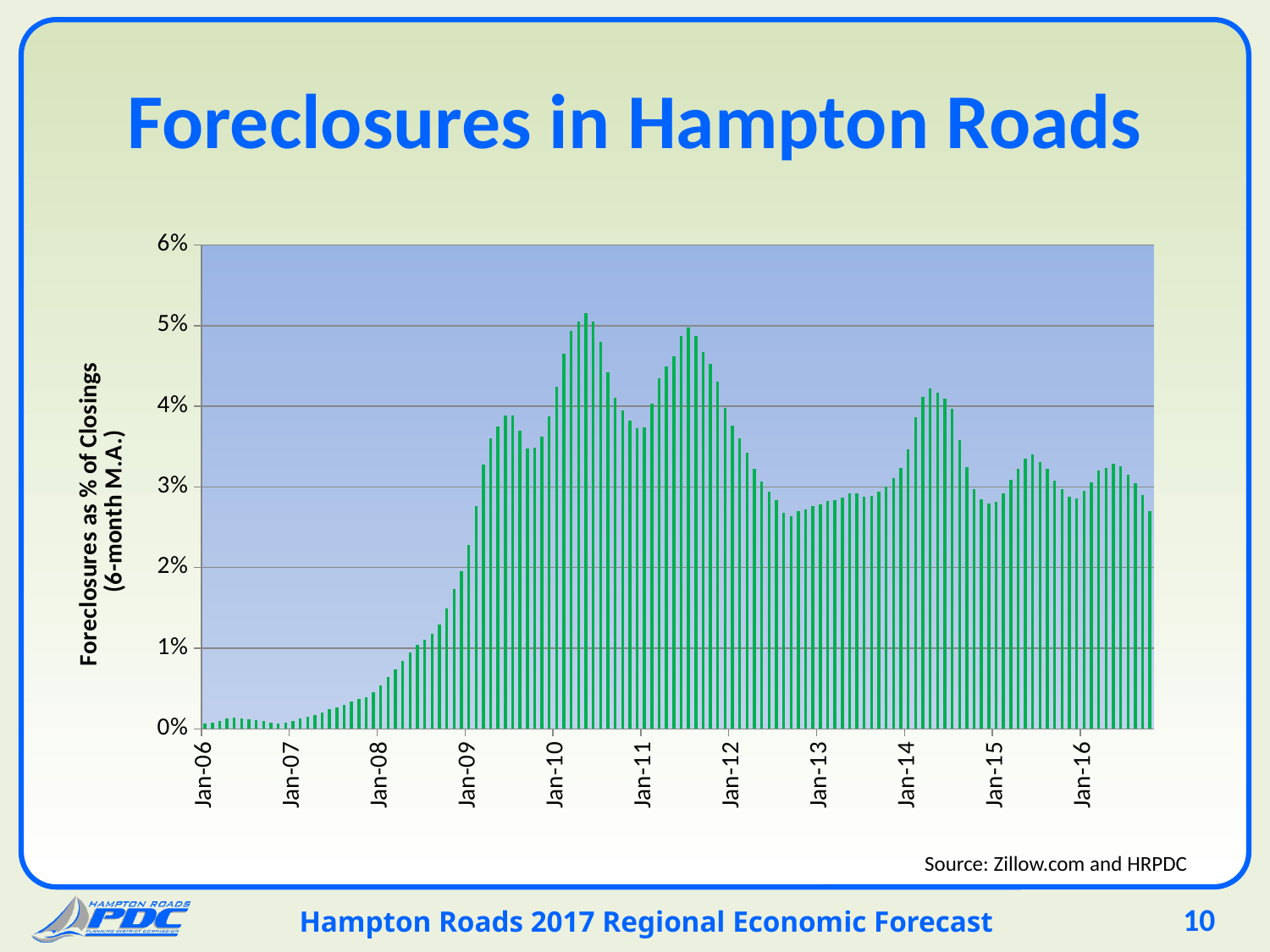
Is the value for Jan-06 greater or less than 1%? less Is the value for Jan-13 greater or less than 3%? less What kind of chart is shown on the slide? bar chart Which is larger, the value for Jan-10 or the value for Jan-13? Jan-10 Is the value for Jan-14 greater or less than 3%? greater What is the label on the vertical axis? Foreclosures as % of Closings (6-month M.A.) Do the values rise or fall from Jan-06 to Jan-10? rise What is the title of the chart? Foreclosures in Hampton Roads How many year labels are shown on the horizontal axis? 11